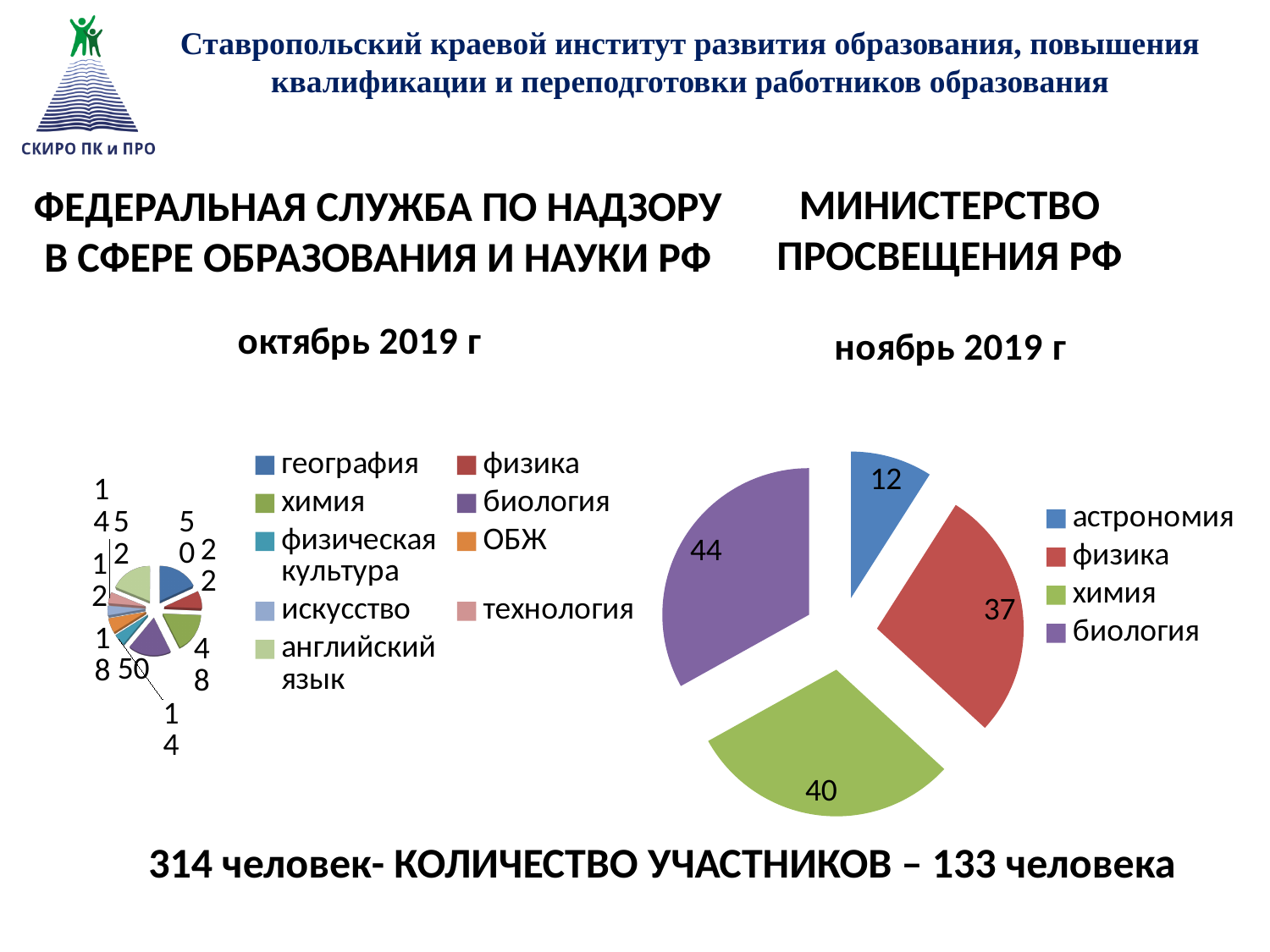
On the right pie chart (ноябрь 2019 г), what is the value for физика? 37 On the right pie chart (ноябрь 2019 г), what is the value for химия? 40 How many categories does the right pie chart (ноябрь 2019 г) show? 4 On the right pie chart (ноябрь 2019 г), what is the value for астрономия? 12 What kind of chart is the left chart (октябрь 2019 г)? pie chart On the right pie chart (ноябрь 2019 г), which category has the smallest slice? астрономия On the right pie chart (ноябрь 2019 г), what is the difference between the values for биология and астрономия? 32 On the right pie chart (ноябрь 2019 г), which is larger, the value for химия or the value for физика? химия On the right pie chart (ноябрь 2019 г), which category has the largest slice? биология What is the total of all slices on the right pie chart (ноябрь 2019 г)? 133 On the right pie chart (ноябрь 2019 г), what is the difference between the values for химия and физика? 3 How many entries does the legend of the left chart (октябрь 2019 г) list? 9